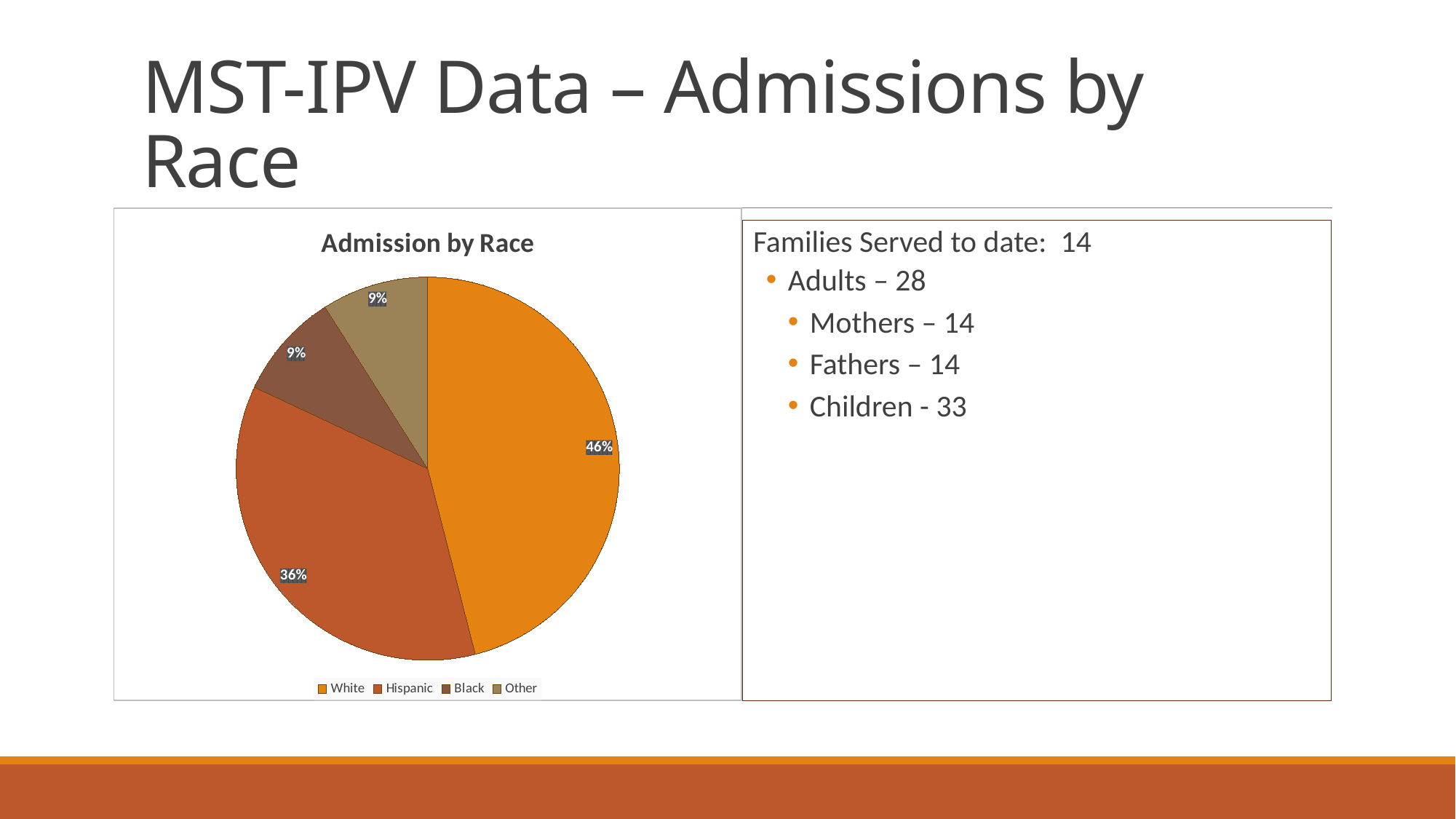
Which race category has the largest share of admissions? White What is the title of the chart? Admission by Race What share of admissions is White? 46% What share of admissions is Hispanic? 36% Which is larger, the Hispanic share or the Black share? Hispanic What share of admissions is Other? 9% What kind of chart is shown on the slide? pie chart How many categories does the pie chart show? 4 How many entries does the legend list? 4 What is the combined share of the Black and Other slices? 18% What share of admissions is Black? 9% What is the difference in percentage points between the White and Hispanic shares? 10